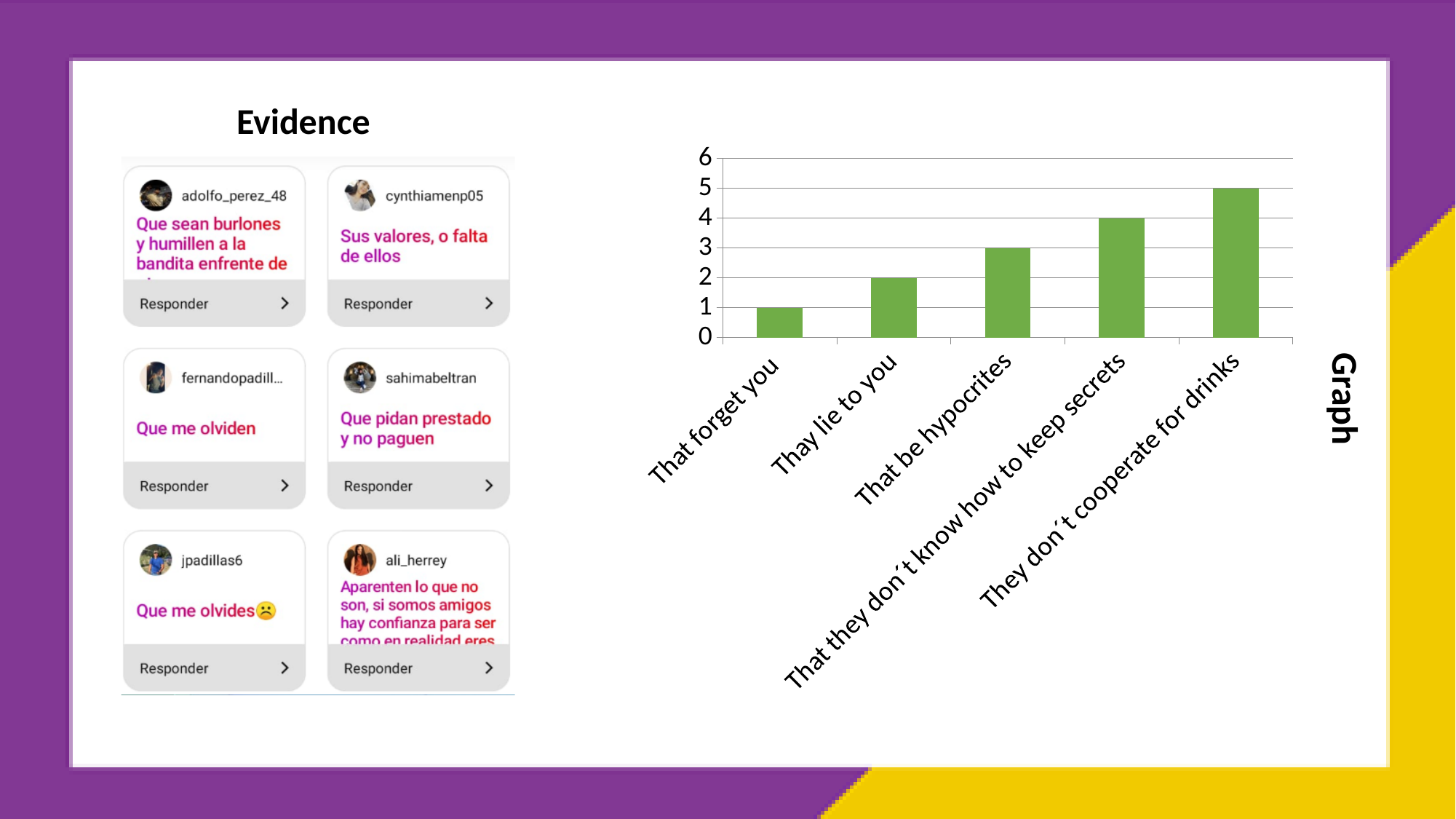
What kind of chart is shown on the slide? Bar chart What is the value for "That be hypocrites"? 3 Which is larger, the value for "That be hypocrites" or the value for "That forget you"? That be hypocrites How many categories are shown on the x axis? 5 What is the value for "Thay lie to you"? 2 What is the value for "That forget you"? 1 Which category has the lowest value? That forget you What is the value for "That they don´t know how to keep secrets"? 4 Do the values rise or fall from left to right along the x axis? Rise What is the difference between the values for "They don´t cooperate for drinks" and "Thay lie to you"? 3 Which category has the highest value? They don´t cooperate for drinks What is the value for "They don´t cooperate for drinks"? 5